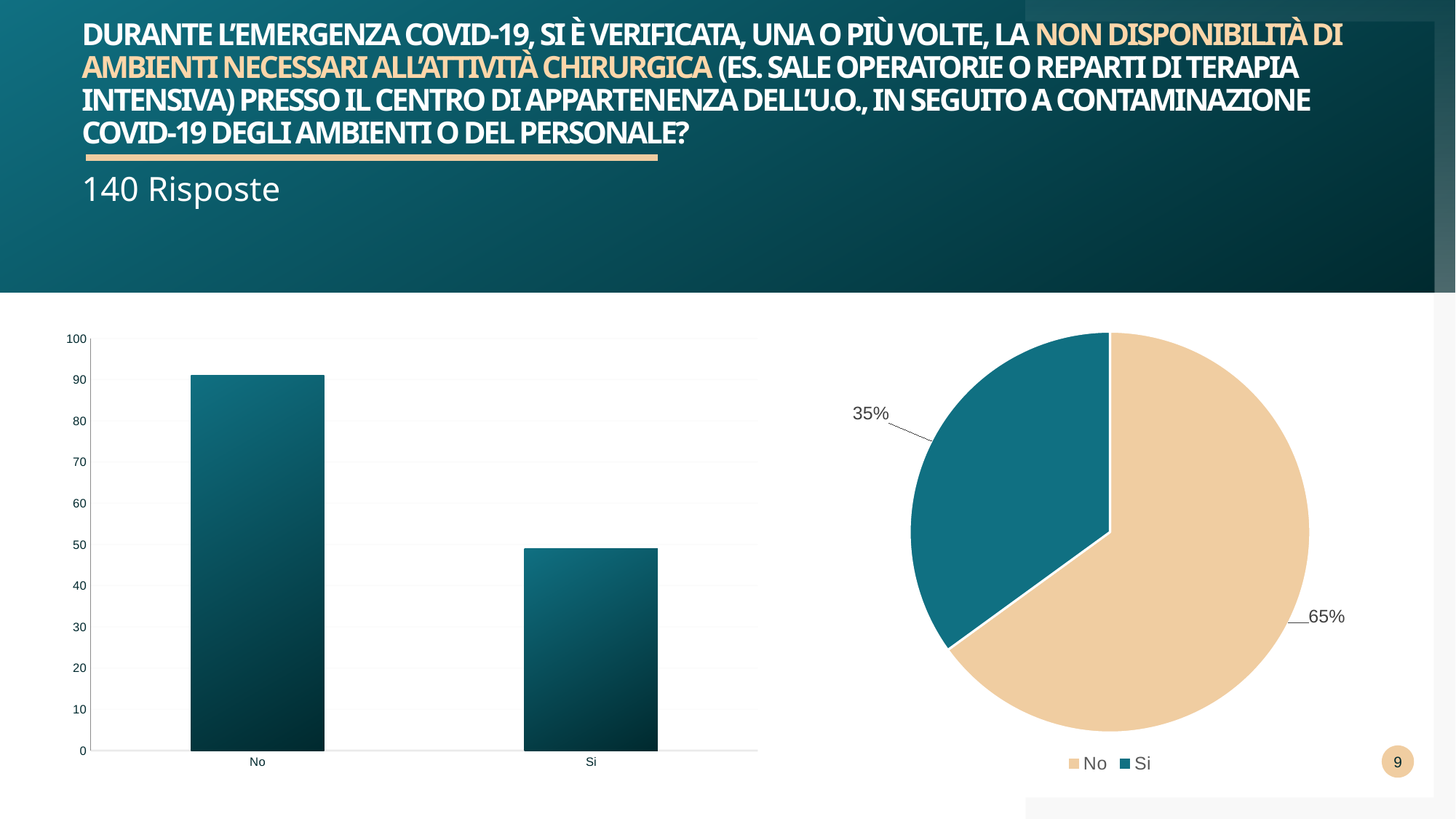
In the bar chart on the left, is the value for Si greater or less than 60? less In the bar chart on the left, which category has the highest bar? No How many categories are shown on the x axis of the bar chart on the left? 2 In the pie chart on the right, what share does the No slice have? 65% What kind of chart is on the left side of the slide? bar chart In the pie chart on the right, what is the difference in percentage points between the No and Si slices? 30 How many entries does the legend of the pie chart on the right list? 2 In the bar chart on the left, is the value for No greater or less than 80? greater What kind of chart is on the right side of the slide? pie chart In the pie chart on the right, which slice is larger, No or Si? No In the pie chart on the right, what share does the Si slice have? 35% In the bar chart on the left, which category has the lowest bar? Si